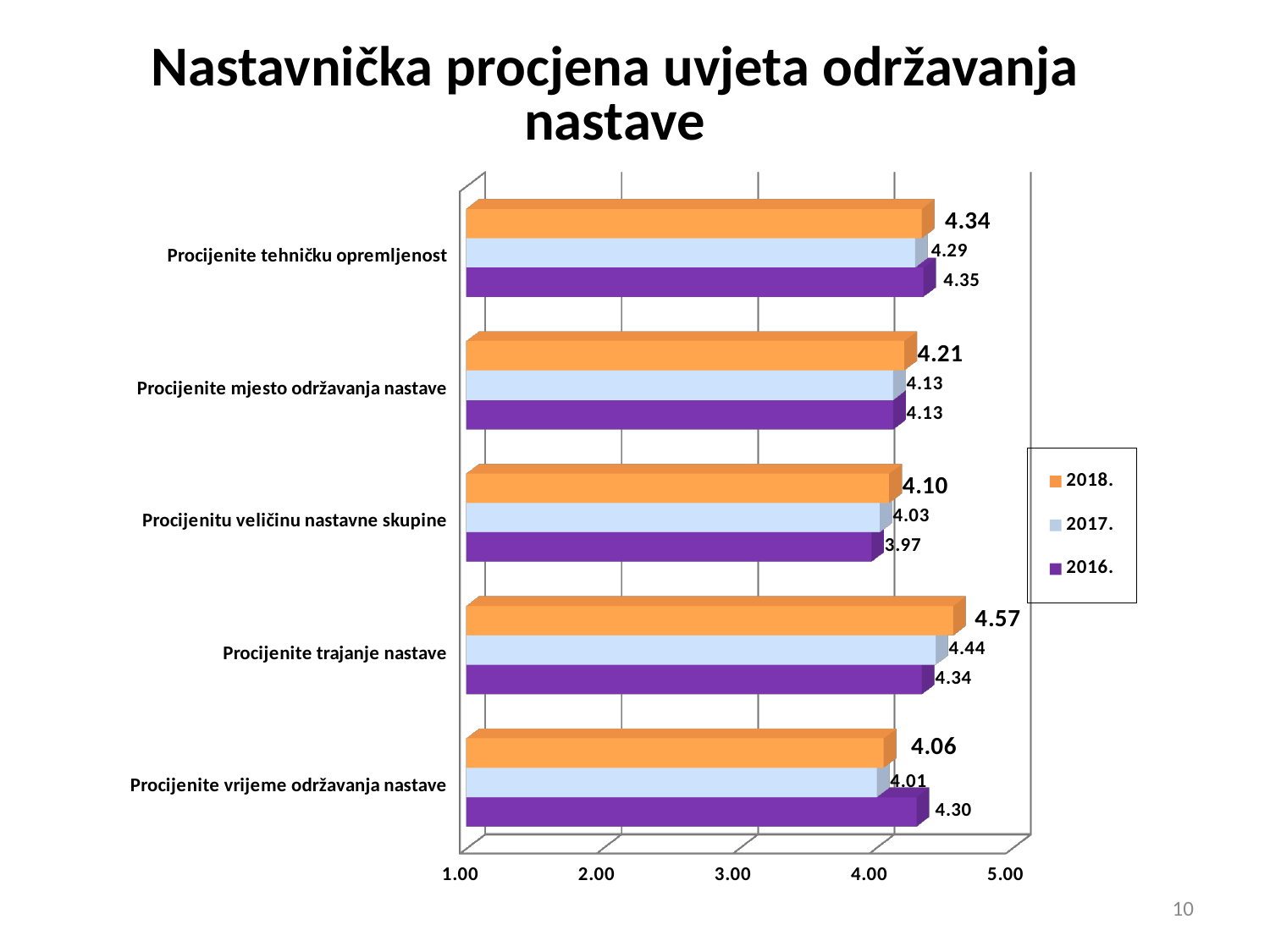
What is the 2016. value for "Procijenite vrijeme održavanja nastave"? 4.30 What kind of chart is shown on the slide? bar chart Which category has the lowest 2016. value? Procijenitu veličinu nastavne skupine How many categories are shown on the chart? 5 Is the 2016. value for "Procijenitu veličinu nastavne skupine" greater or less than 4.00? less What is the title of the chart on the slide? Nastavnička procjena uvjeta održavanja nastave Which category has the highest 2018. value? Procijenite trajanje nastave For "Procijenite vrijeme održavanja nastave", which is larger: the 2018. value or the 2016. value? 2016. What is the 2017. value for "Procijenitu veličinu nastavne skupine"? 4.03 How many series does the legend list? 3 What is the 2018. value for "Procijenite trajanje nastave"? 4.57 What is the difference between the 2018. and 2016. values for "Procijenite trajanje nastave"? 0.23